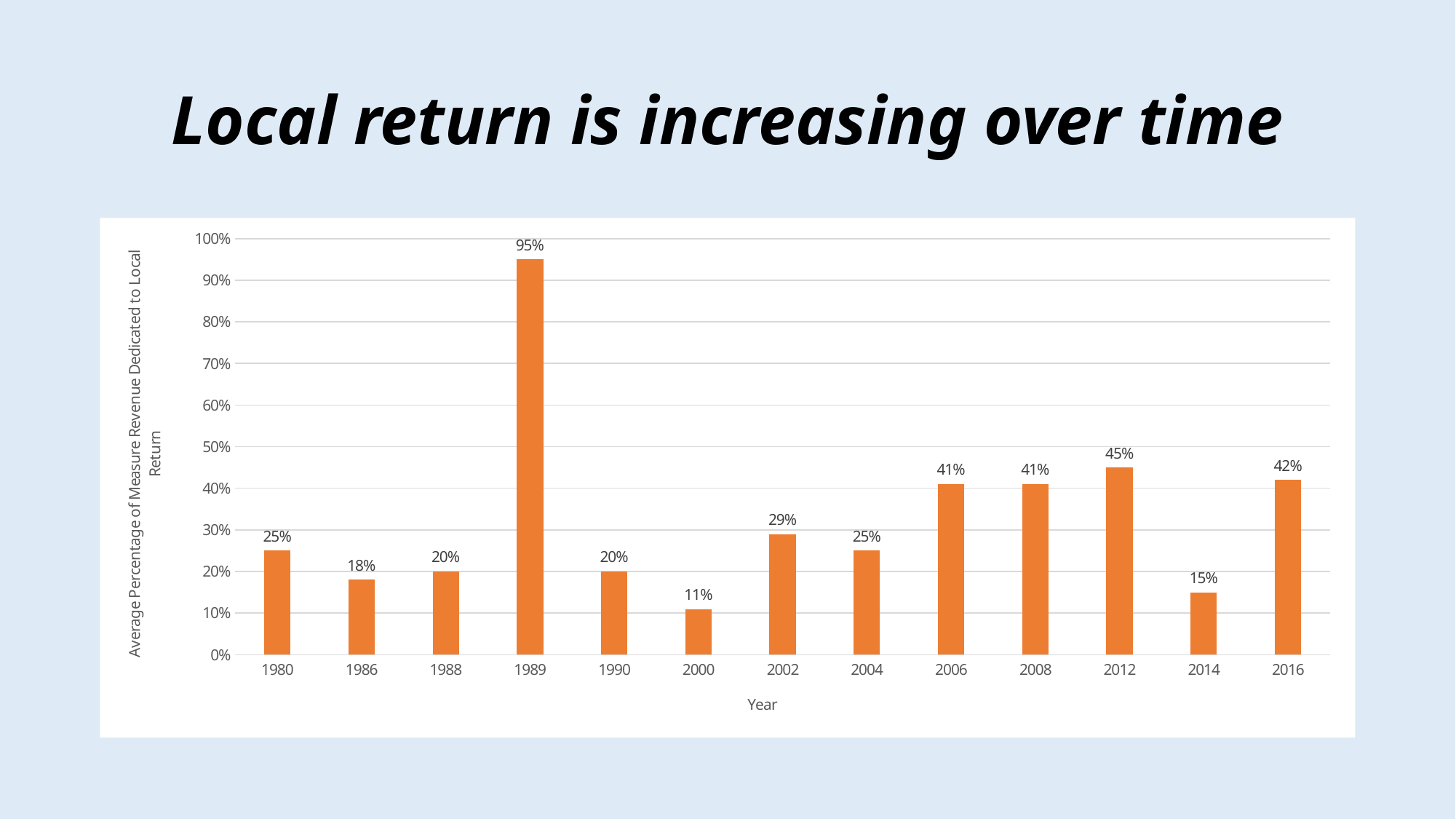
What is the difference between the values for 2016 and 2014? 27% What is the value for 1989? 95% What is the value for 2000? 11% Which year has the lowest value? 2000 Is the value for 2006 greater or less than 30%? greater What kind of chart is shown on the slide? bar chart Which is larger, the value for 2002 or the value for 2004? 2002 What is the label of the x axis? Year What is the value for 2012? 45% Which year has the highest value? 1989 How many years are shown on the x axis? 13 What is the title of the slide? Local return is increasing over time